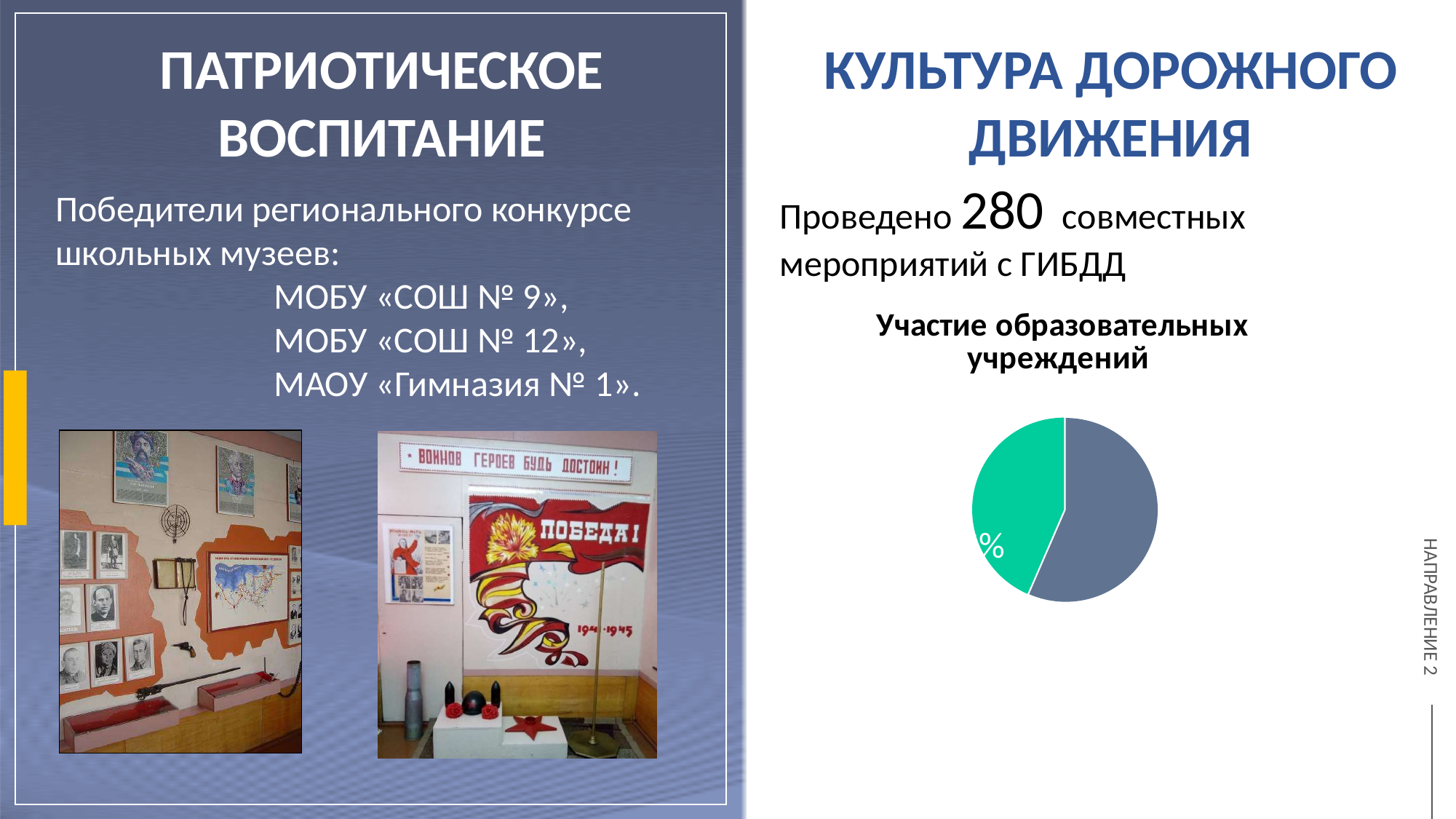
In the pie chart "Участие образовательных учреждений", which slice is larger, the dark blue-grey one or the green one? the dark blue-grey one What kind of chart is shown under the heading "Участие образовательных учреждений"? pie chart How many slices does the pie chart "Участие образовательных учреждений" have? 2 What two colours are used for the slices of the pie chart "Участие образовательных учреждений"? dark blue-grey and green What is the title of the pie chart on the right side of the slide? Участие образовательных учреждений In the pie chart "Участие образовательных учреждений", which slice is the smallest? the green slice